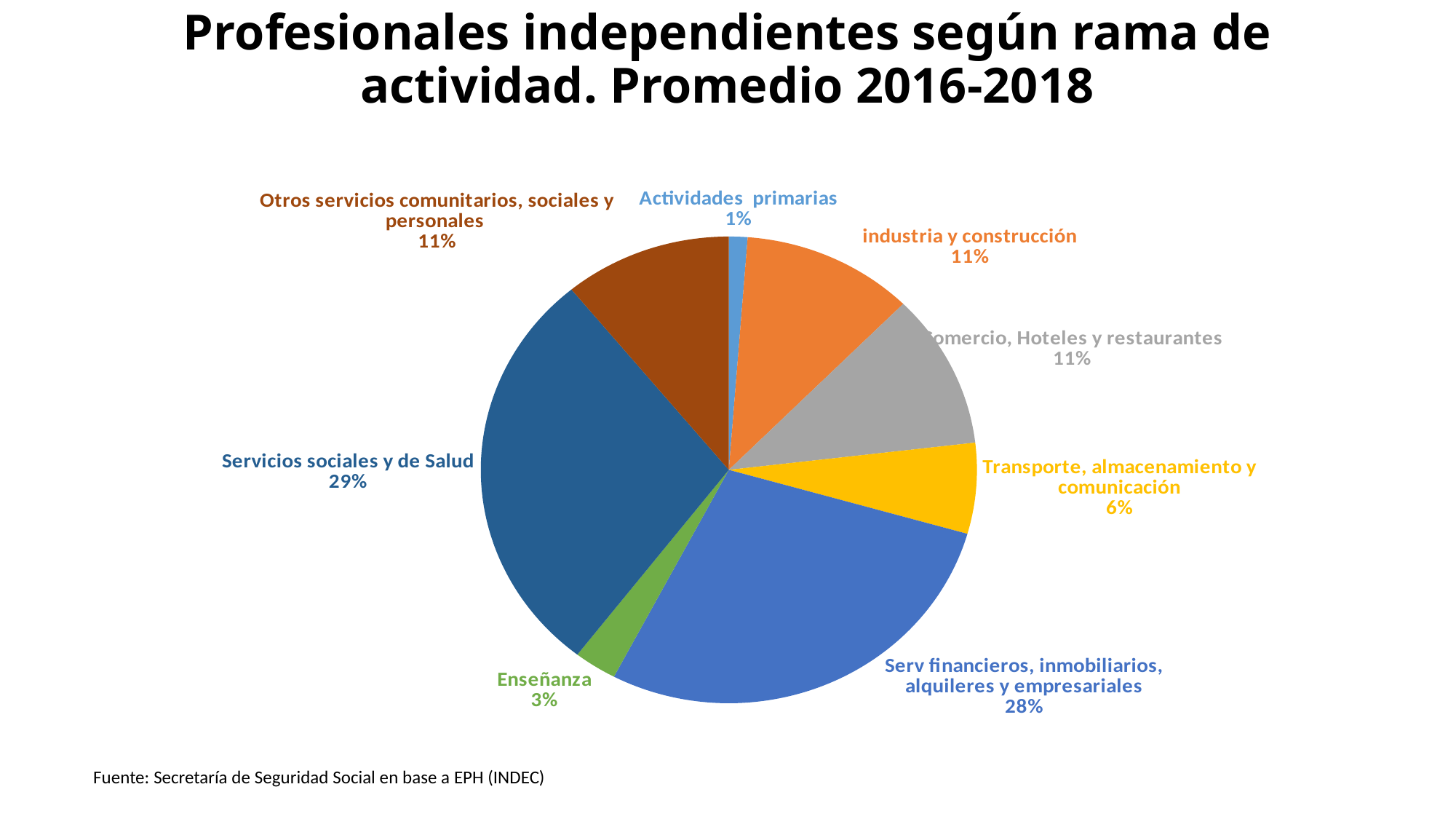
How many categories (slices) does the pie chart have? 8 Which category has the largest slice of the pie? Servicios sociales y de Salud Which category has the smallest slice of the pie? Actividades primarias What percentage is shown for Enseñanza? 3% What percentage is shown for Transporte, almacenamiento y comunicación? 6% What percentage is shown for Comercio, Hoteles y restaurantes? 11% Which is larger: the share for Transporte, almacenamiento y comunicación or the share for Enseñanza? Transporte, almacenamiento y comunicación What percentage is shown for Serv financieros, inmobiliarios, alquileres y empresariales? 28% What is the title of the chart? Profesionales independientes según rama de actividad. Promedio 2016-2018 What share of independent professionals is in Servicios sociales y de Salud? 29% What kind of chart is shown on the slide? Pie chart What is the difference in percentage points between Servicios sociales y de Salud and Enseñanza? 26 percentage points